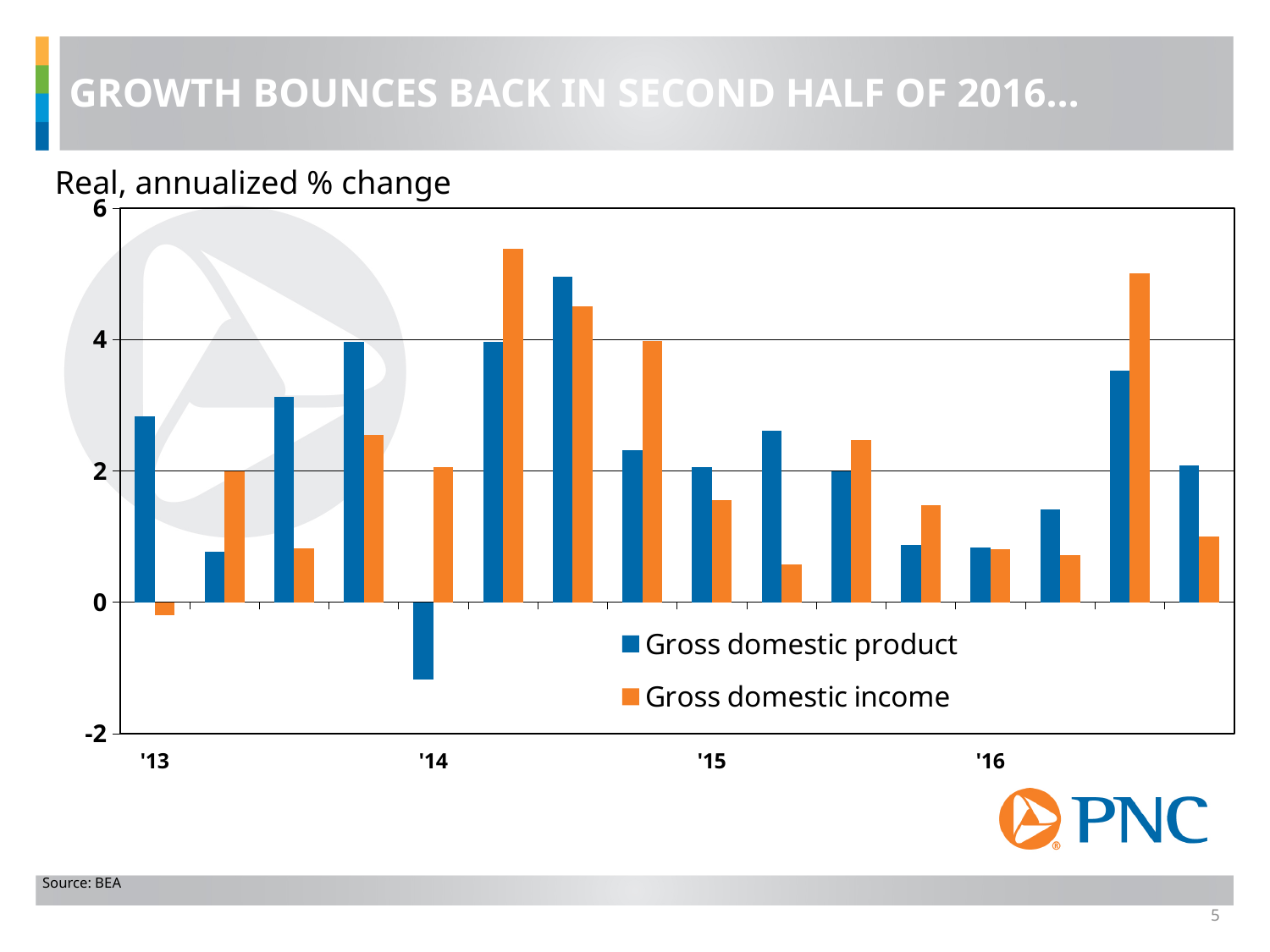
How many series does the legend list? 2 Is the Gross domestic income value for the second quarter of '14 greater or less than 4? greater What unit or measure is stated above the chart? Real, annualized % change In which quarter is the Gross domestic product bar the lowest? first quarter of '14 In which quarter is the Gross domestic product bar the highest? third quarter of '14 Is the Gross domestic product value for the first quarter of '13 greater or less than 2? greater How many quarters (pairs of bars) are plotted on the chart? 16 What kind of chart is shown on the slide? bar chart Is the Gross domestic product value for the first quarter of '14 greater or less than 0? less From the first quarter of '16 to the third quarter of '16, do the Gross domestic product bars rise or fall? rise In the first quarter of '14, which is larger, Gross domestic product or Gross domestic income? Gross domestic income Which two series are listed in the legend? Gross domestic product and Gross domestic income